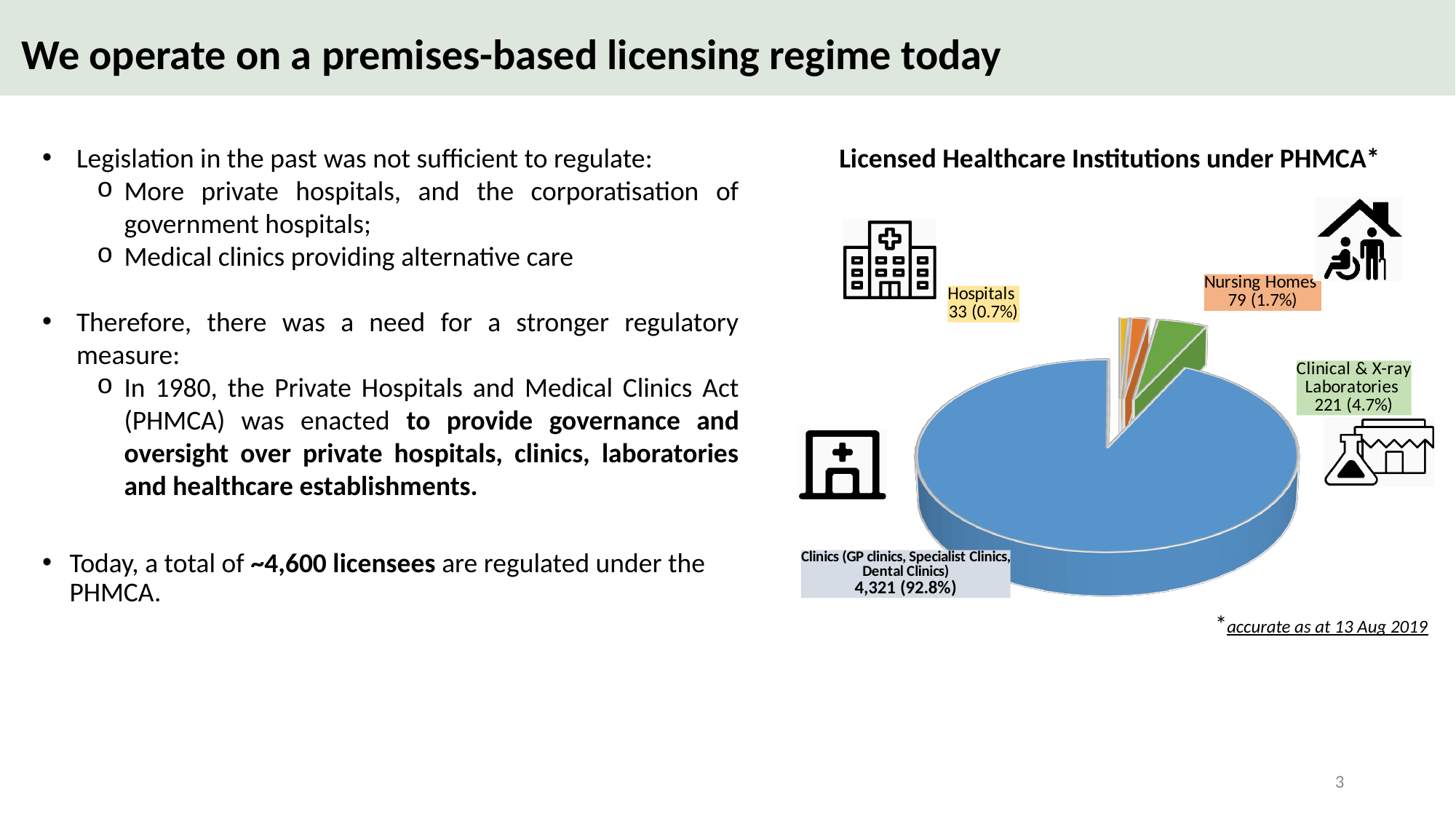
Which is larger, the number of Nursing Homes or the number of Hospitals? Nursing Homes How many Clinical & X-ray Laboratories are shown in the chart? 221 What is the difference between the number of Clinical & X-ray Laboratories and the number of Nursing Homes? 142 Which category has the largest slice of the pie? Clinics (GP clinics, Specialist Clinics, Dental Clinics) What share of the pie do Clinics (GP clinics, Specialist Clinics, Dental Clinics) represent? 92.8% Which category has the smallest slice of the pie? Hospitals What type of chart is shown on the slide? Pie chart How many Hospitals are shown in the chart? 33 What is the value shown for Clinics (GP clinics, Specialist Clinics, Dental Clinics)? 4,321 What is the title of the chart? Licensed Healthcare Institutions under PHMCA* How many Nursing Homes are shown in the chart? 79 What share of the pie do Nursing Homes represent? 1.7%